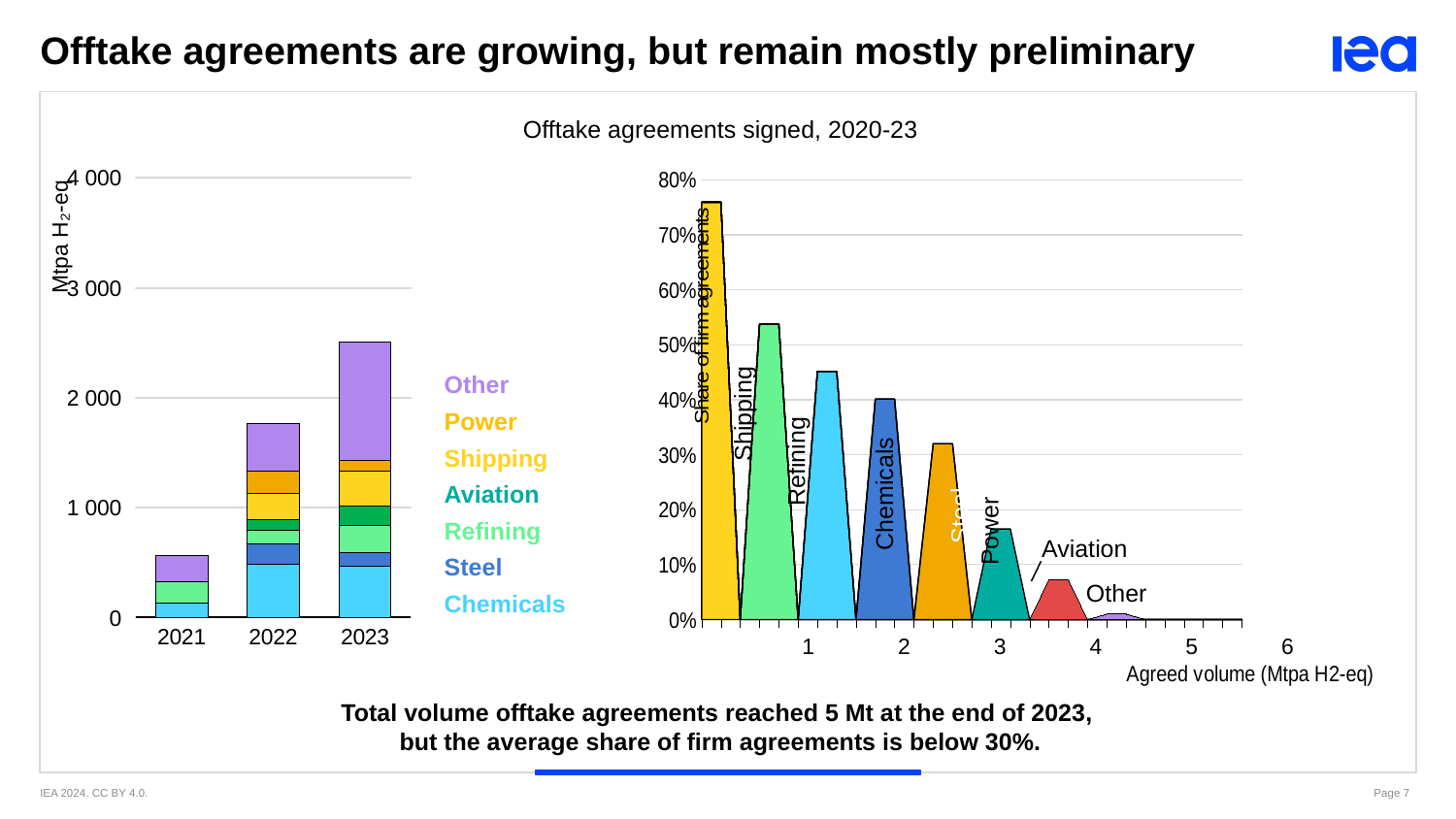
In the left chart, which year has the tallest total bar? 2023 What is the title shown above the charts on the slide? Offtake agreements signed, 2020-23 In the right chart, is the peak share of firm agreements for Chemicals greater or less than 30%? greater In the left chart, how many years are shown on the x axis? 3 In the left chart, is the total bar for 2021 greater or less than 1 000 Mtpa H2-eq? less In the left chart, which year has the shortest total bar? 2021 In the left chart, is the total bar for 2023 greater or less than 2 000 Mtpa H2-eq? greater In the left chart, how many sectors does the legend list? 7 In the right chart, what is the label of the x axis? Agreed volume (Mtpa H2-eq) In the left chart, what kind of chart is used to show the volumes for 2021, 2022 and 2023? Stacked bar chart In the left chart, do the total bar heights rise or fall from 2021 to 2023? Rise